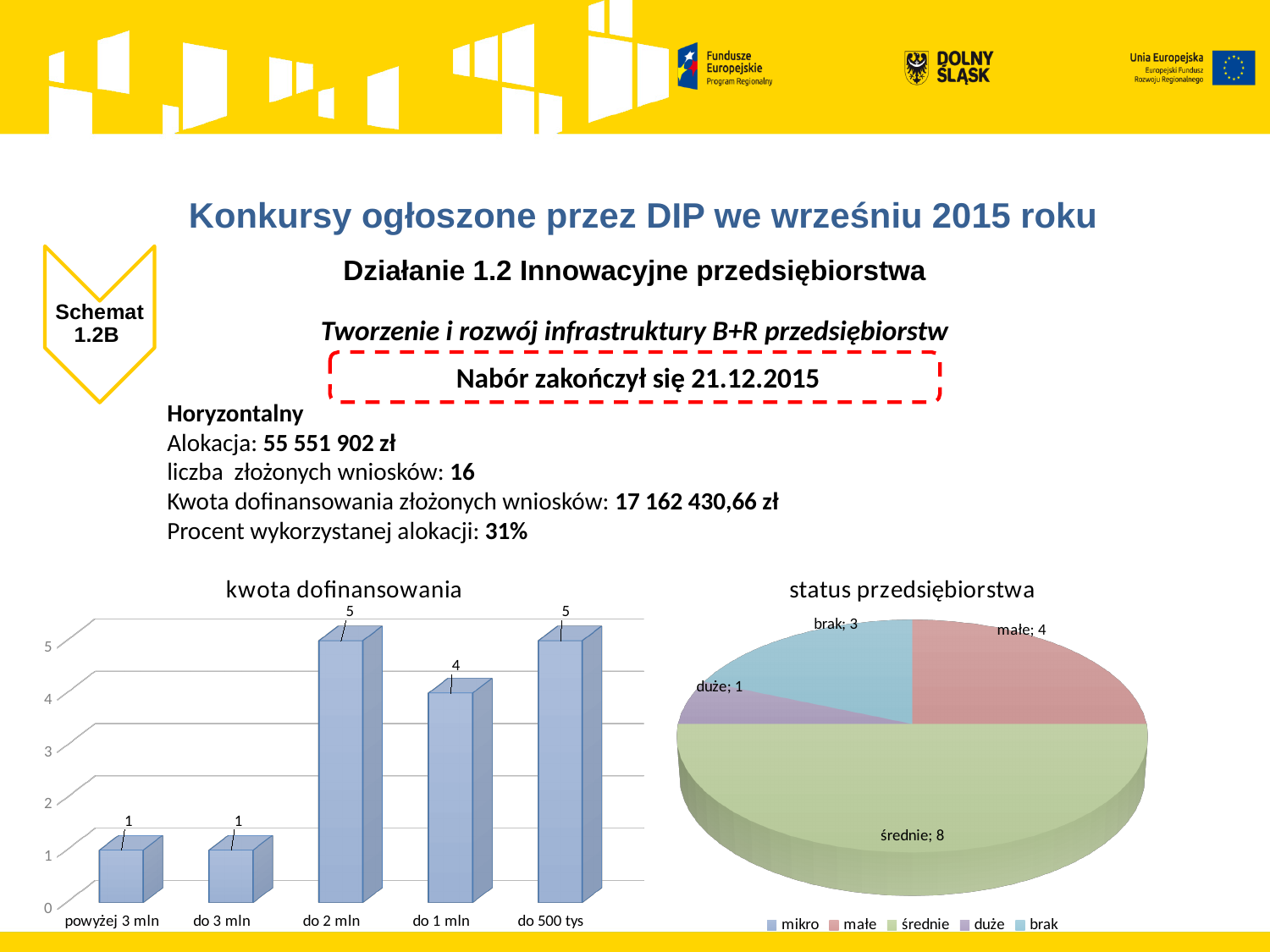
In the 'kwota dofinansowania' chart, what is the value for 'powyżej 3 mln'? 1 In the 'status przedsiębiorstwa' pie chart, what is the value for 'brak'? 3 In the 'status przedsiębiorstwa' pie chart, what is the value for 'średnie'? 8 In the 'status przedsiębiorstwa' pie chart, which labelled category has the lowest value? duże In the 'kwota dofinansowania' chart, which is larger: the value for 'do 1 mln' or the value for 'do 3 mln'? do 1 mln In the 'kwota dofinansowania' chart, what is the difference between the values for 'do 2 mln' and 'do 3 mln'? 4 How many entries does the legend of the 'status przedsiębiorstwa' pie chart list? 5 How many categories are shown on the x axis of the 'kwota dofinansowania' chart? 5 In the 'status przedsiębiorstwa' pie chart, what is the difference between the values for 'średnie' and 'małe'? 4 What kind of chart is the 'kwota dofinansowania' chart? bar chart In the 'kwota dofinansowania' chart, what is the value for 'do 1 mln'? 4 In the 'kwota dofinansowania' chart, what is the value for 'do 2 mln'? 5